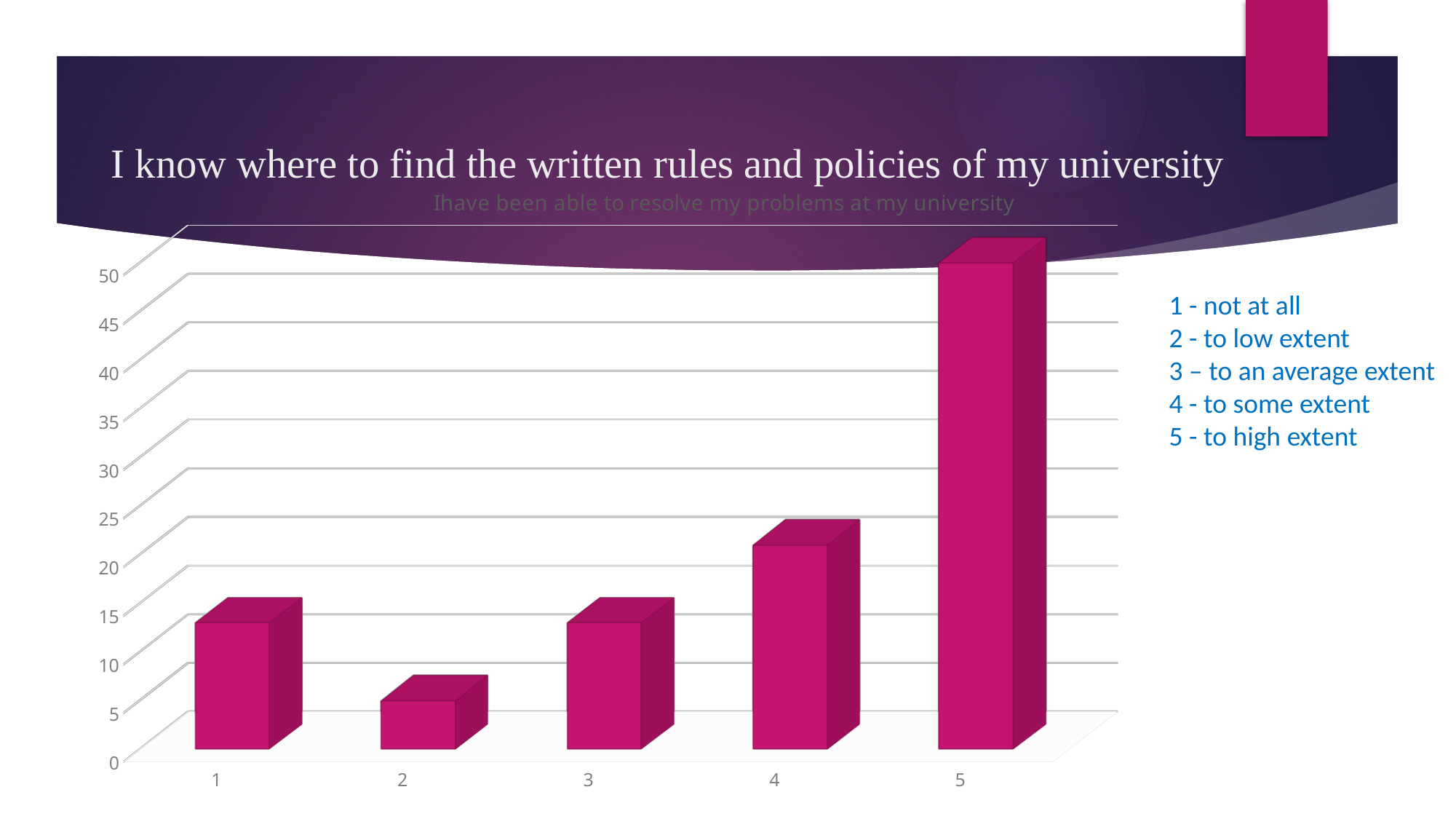
Is the value for category 3 greater or less than 15? less Which category has the lowest bar? 2 Is the value for category 4 greater or less than 25? less Which category has the highest bar? 5 Which is larger, the value for category 4 or the value for category 2? category 4 According to the key on the slide, what does the rating 5 stand for? to high extent Is the value for category 1 greater or less than 10? greater Which is larger, the value for category 5 or the value for category 4? category 5 What kind of chart is shown on the slide? bar chart How many categories are plotted on the x axis? 5